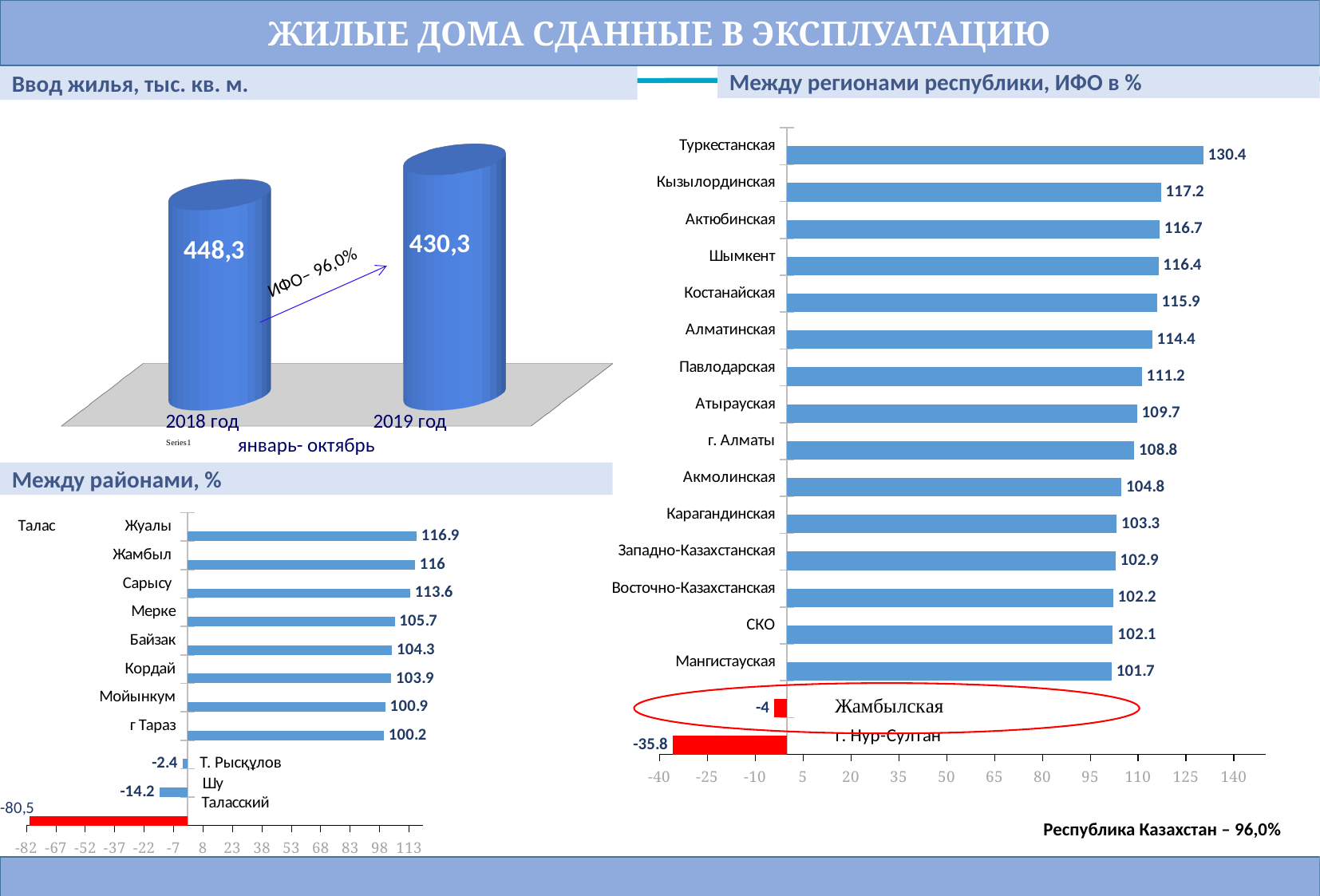
In the chart 'Между регионами республики, ИФО в %', which region has the lowest value? г. Нур-Султан In the chart 'Между регионами республики, ИФО в %', which is larger, Павлодарская or Атырауская? Павлодарская In the chart 'Между регионами республики, ИФО в %', what is the value for Жамбылская? -4 In the chart 'Между районами, %', how many districts are plotted? 11 In the top-left chart 'Ввод жилья, тыс. кв. м.', what is the difference between 2018 год and 2019 год? 18,0 In the chart 'Между регионами республики, ИФО в %', how many regions are plotted? 17 In the top-left chart 'Ввод жилья, тыс. кв. м.', what is the value for 2019 год? 430,3 In the chart 'Между регионами республики, ИФО в %', what is the difference between Туркестанская and Кызылординская? 13.2 In the chart 'Между регионами республики, ИФО в %', what is the value for Туркестанская? 130.4 In the chart 'Между районами, %', which district has the highest value? Жуалы In the chart 'Между районами, %', what is the value for Шу? -14.2 In the chart 'Между районами, %', what is the value for Сарысу? 113.6